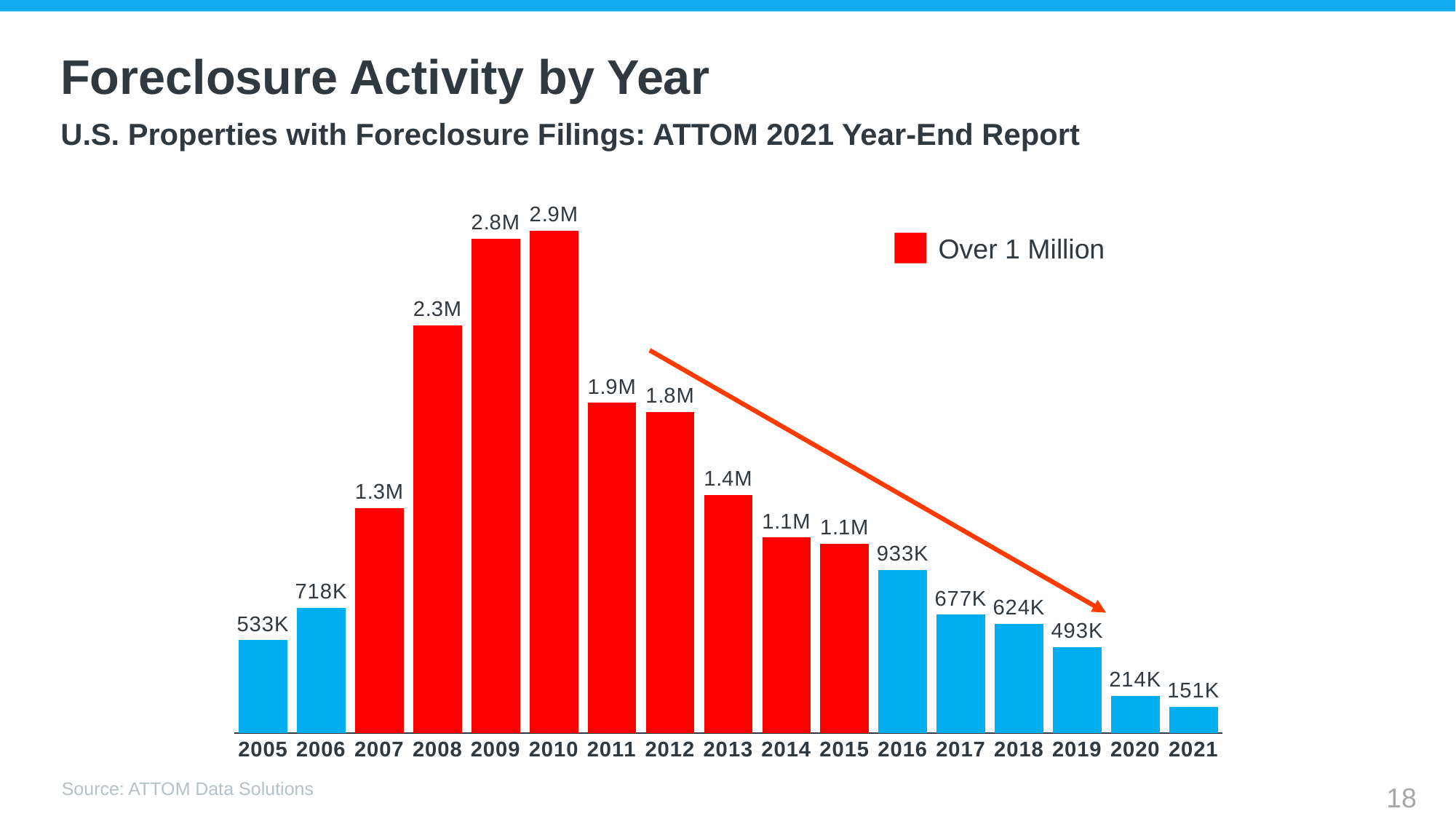
Which year has the highest value? 2010 What is the difference between the values for 2017 and 2018? 53K What does the red colour in the legend represent? Over 1 Million How many years are shown on the x axis? 17 Do the values rise or fall from 2010 to 2021? Fall What is the value for 2016? 933K What kind of chart is shown? Bar chart Which year has the lowest value? 2021 What is the value for 2010? 2.9M Which is larger, the value for 2007 or the value for 2013? 2013 What is the value for 2021? 151K What is the value for 2005? 533K